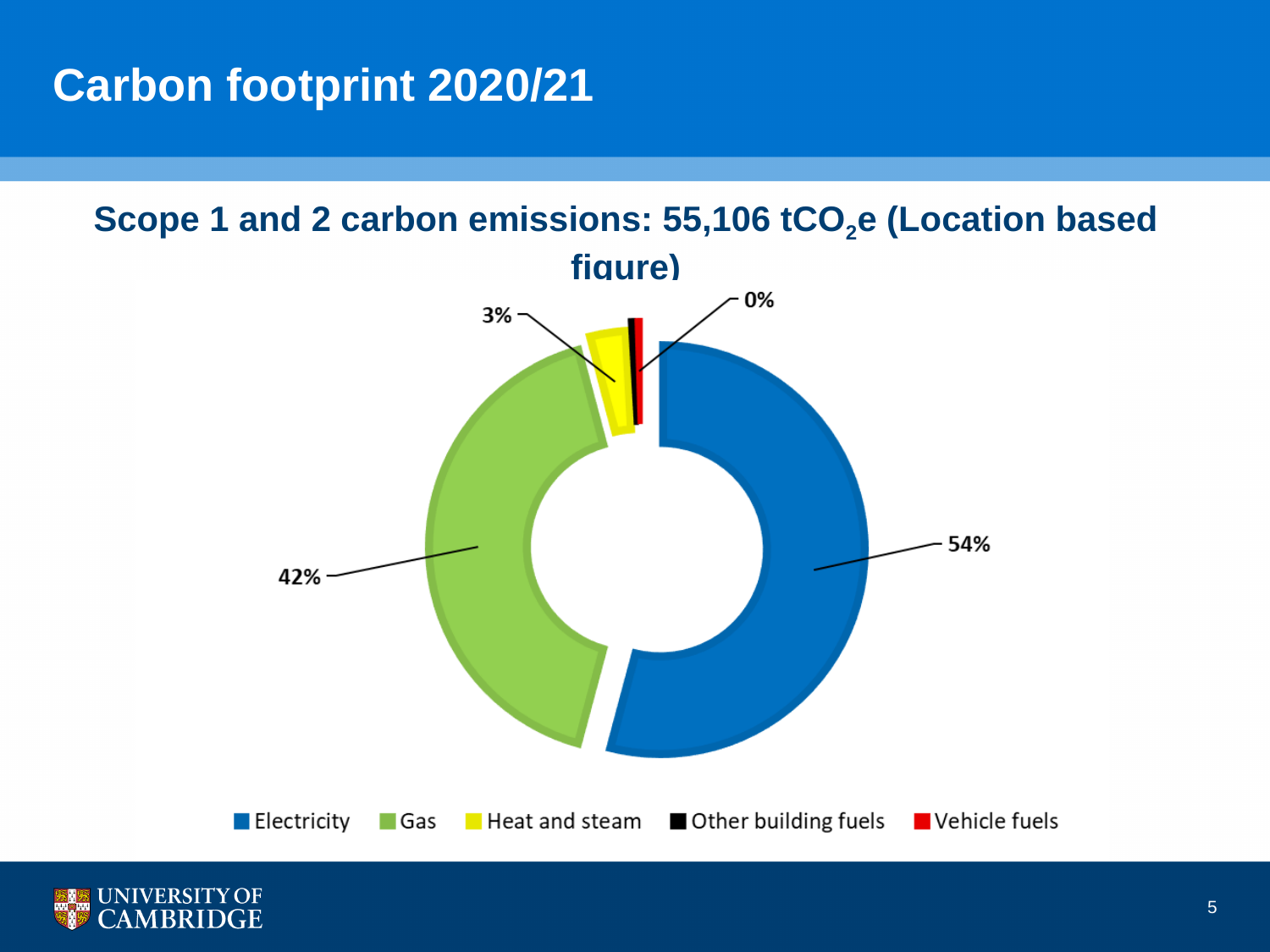
What kind of chart is shown on the slide? Doughnut (pie) chart How many categories does the chart legend list? 5 Which is larger, the share for Electricity or the share for Gas? Electricity Which category has the largest share of Scope 1 and 2 carbon emissions? Electricity What colour represents Gas in the chart? Green What share of Scope 1 and 2 carbon emissions does Heat and steam account for? 3% What share of Scope 1 and 2 carbon emissions does Electricity account for? 54% Which is larger, the share for Gas or the share for Heat and steam? Gas What total Scope 1 and 2 carbon emissions figure is given in the chart title? 55,106 tCO2e By how many percentage points does the Gas share exceed the Heat and steam share? 39 percentage points What share of Scope 1 and 2 carbon emissions does Gas account for? 42% By how many percentage points does the Electricity share exceed the Gas share? 12 percentage points